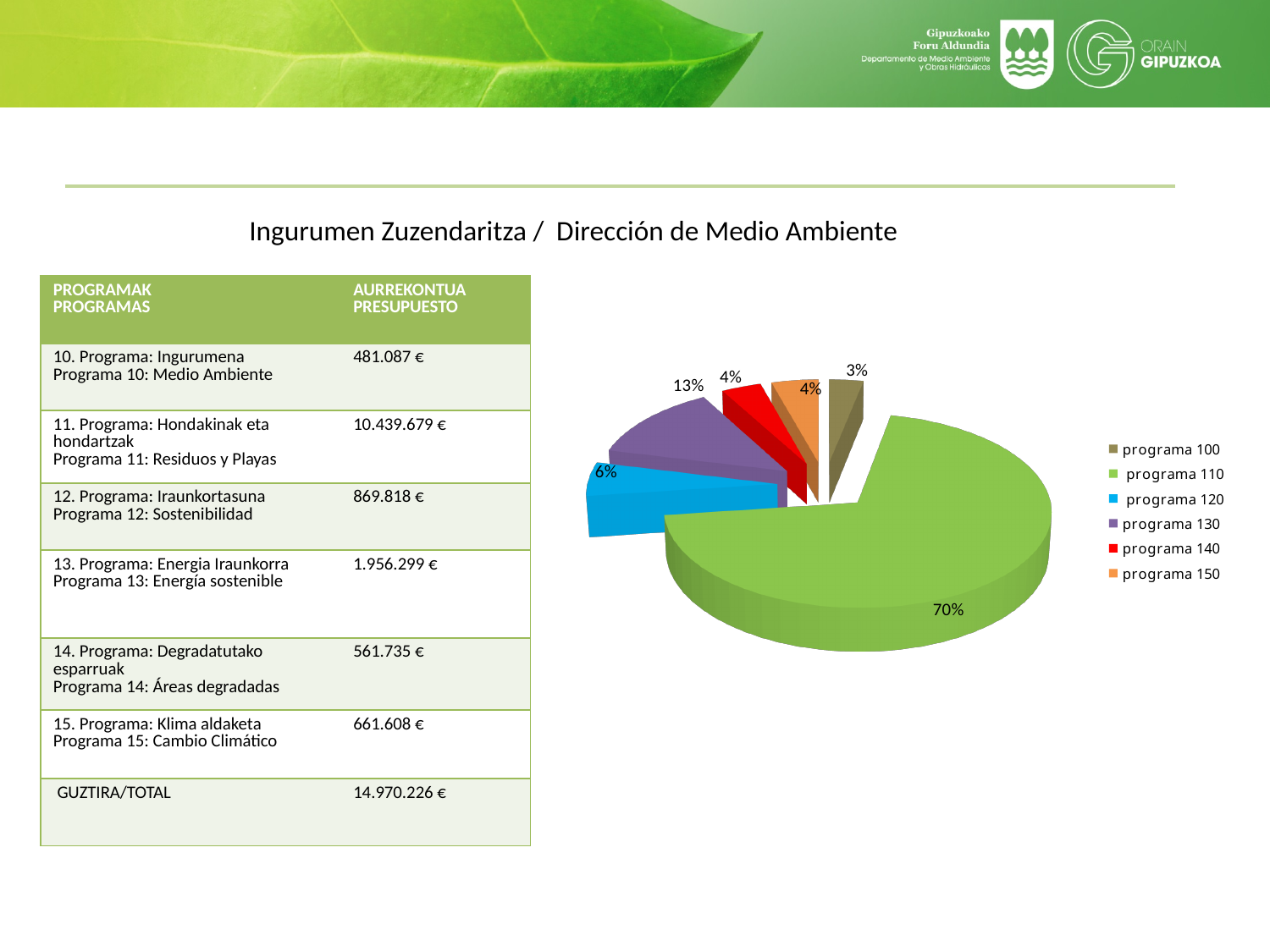
What share of the pie does programa 110 represent? 70% What share of the pie does programa 130 represent? 13% How many series does the chart legend list? 6 Which programa has the smallest slice of the pie? programa 100 Which legend entry is shown in red? programa 140 What is the difference between the share for programa 110 and the share for programa 130? 57% What kind of chart is shown on the slide? pie chart Which is larger, the share for programa 130 or the share for programa 120? programa 130 What share of the pie does programa 120 represent? 6% Which programa has the largest slice of the pie? programa 110 How many slices does the pie chart have? 6